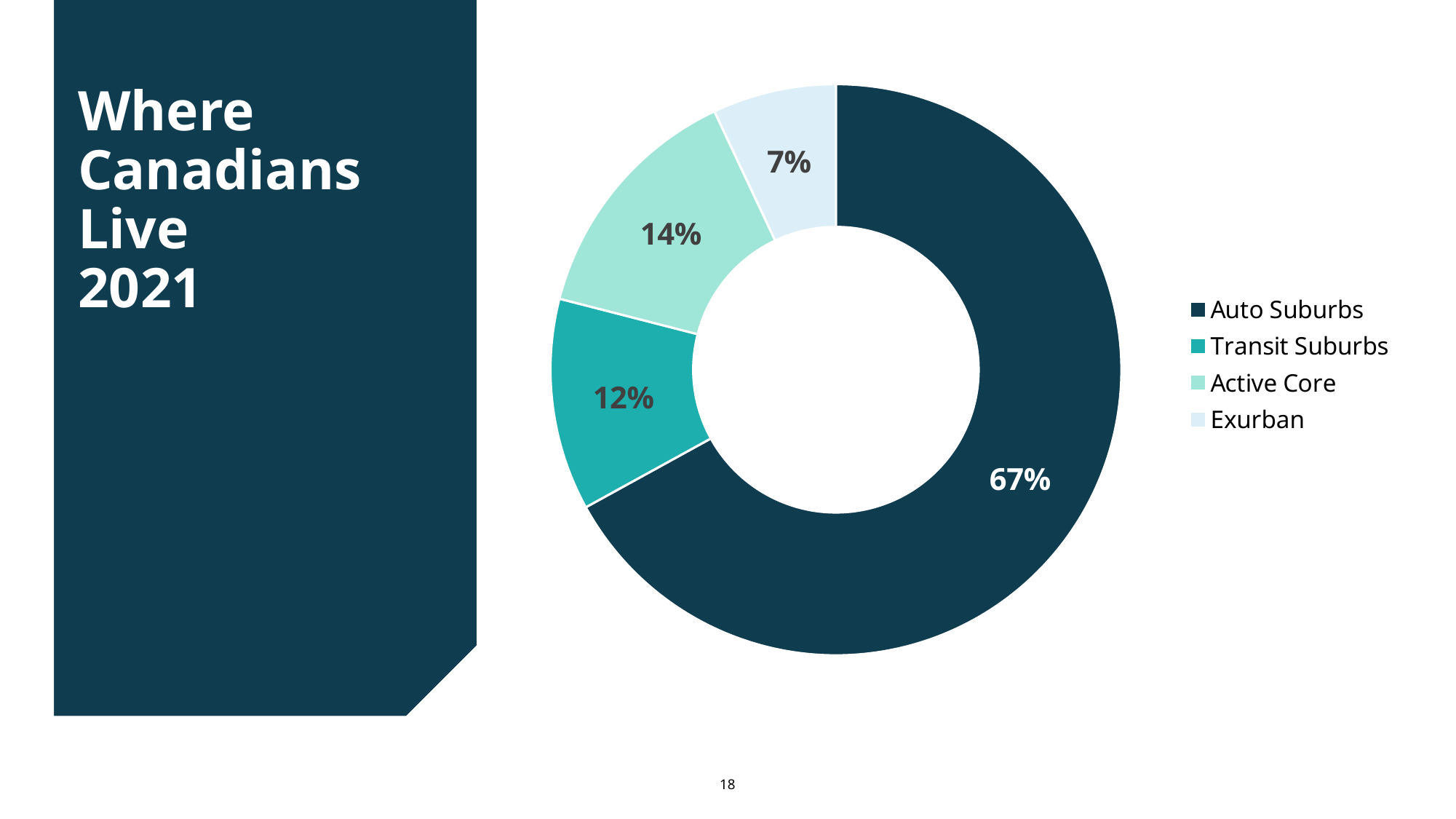
How many categories does the chart show? 4 What is the difference in percentage points between Auto Suburbs and Active Core? 53 What share of Canadians live in Auto Suburbs? 67% What kind of chart is shown on the slide? Pie chart (doughnut) Which category has the largest share of the chart? Auto Suburbs Which is larger, the share for Active Core or the share for Transit Suburbs? Active Core What share of Canadians live in Transit Suburbs? 12% What share of Canadians live in the Active Core? 14% Which category has the smallest share of the chart? Exurban What share of Canadians live in Exurban areas? 7% Which legend entry is shown in the darkest colour? Auto Suburbs What is the title of the slide? Where Canadians Live 2021